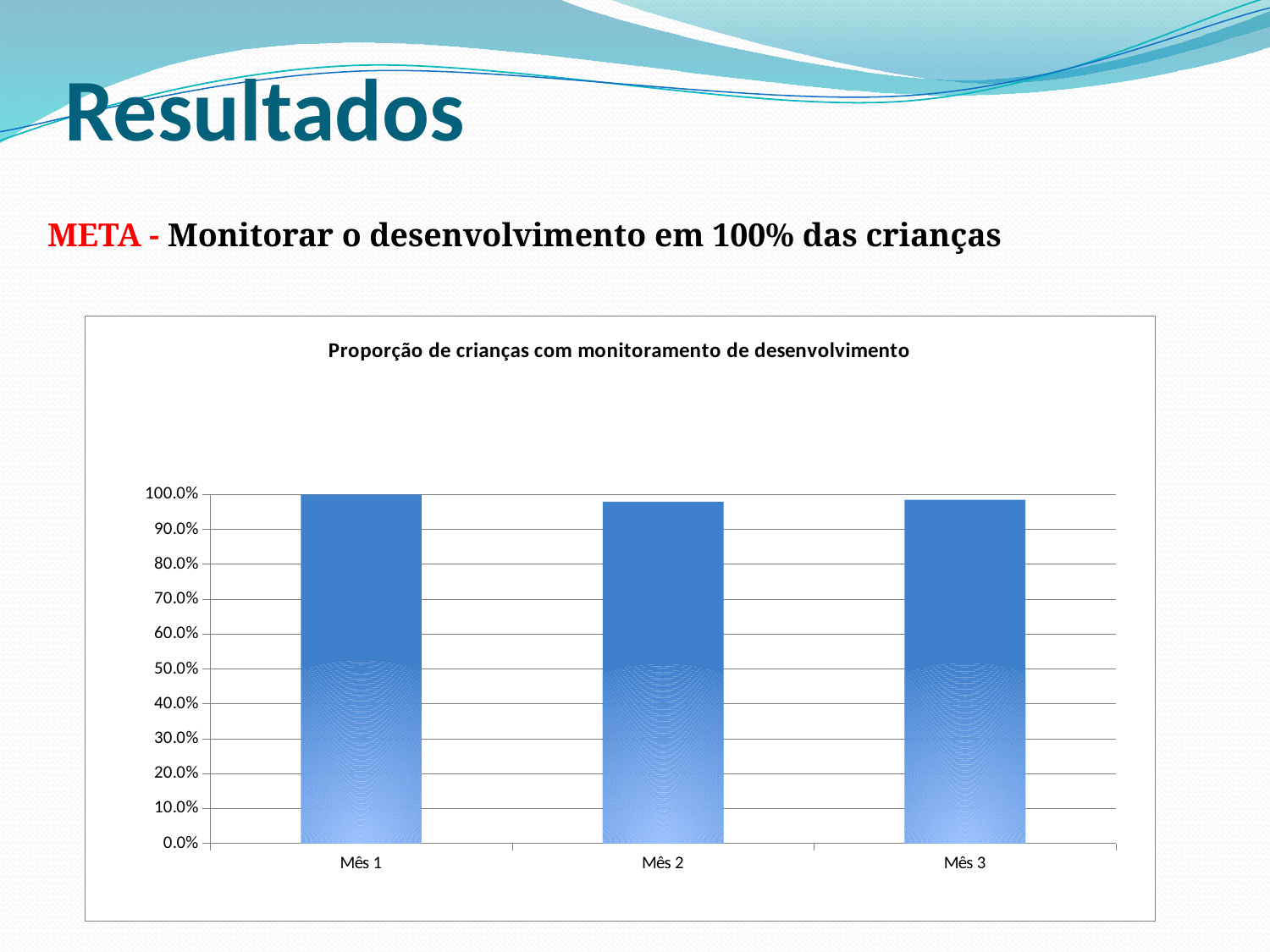
Is the value for Mês 3 greater or less than 90.0%? greater How many months (categories) are shown on the x axis of the chart? 3 Is the value for Mês 2 greater or less than 90.0%? greater Is the value for Mês 2 greater or less than 100.0%? less Which is larger, the value for Mês 1 or the value for Mês 2? Mês 1 What is the title of the chart? Proporção de crianças com monitoramento de desenvolvimento Which month has the highest value? Mês 1 What is the value for Mês 1? 100.0% What is the label of the first category on the x axis? Mês 1 What type of chart is shown on the slide? Bar chart What is the maximum value shown on the y axis? 100.0%